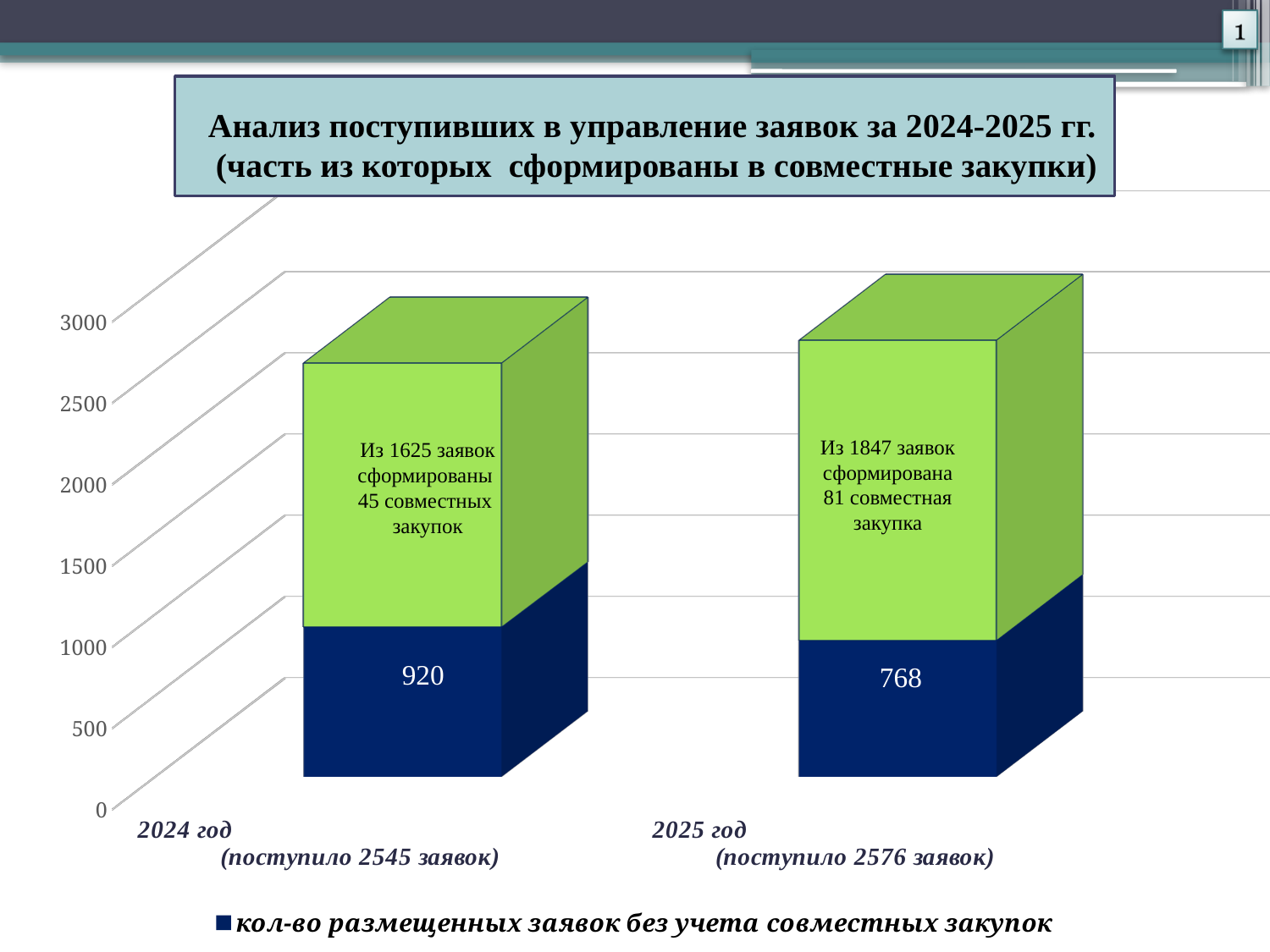
What is the difference between the dark blue segment values for 2024 год and 2025 год? 152 What is the value of the dark blue segment for 2024 год? 920 How many joint purchases (совместных закупок) were formed in 2025 according to the green segment label? 81 Is the dark blue segment value for 2025 год greater or less than 1000? less How many applications (заявок) are stated as received in total for 2024 год? 2545 Which year has the larger dark blue segment, 2024 год or 2025 год? 2024 год How many categories (years) are shown on the x axis? 2 How many entries does the legend list? 1 What is the value of the dark blue segment for 2025 год? 768 What type of chart is shown on the slide? stacked bar chart How many joint purchases (совместных закупок) were formed in 2024 according to the green segment label? 45 How many applications (заявок) are stated as received in total for 2025 год? 2576